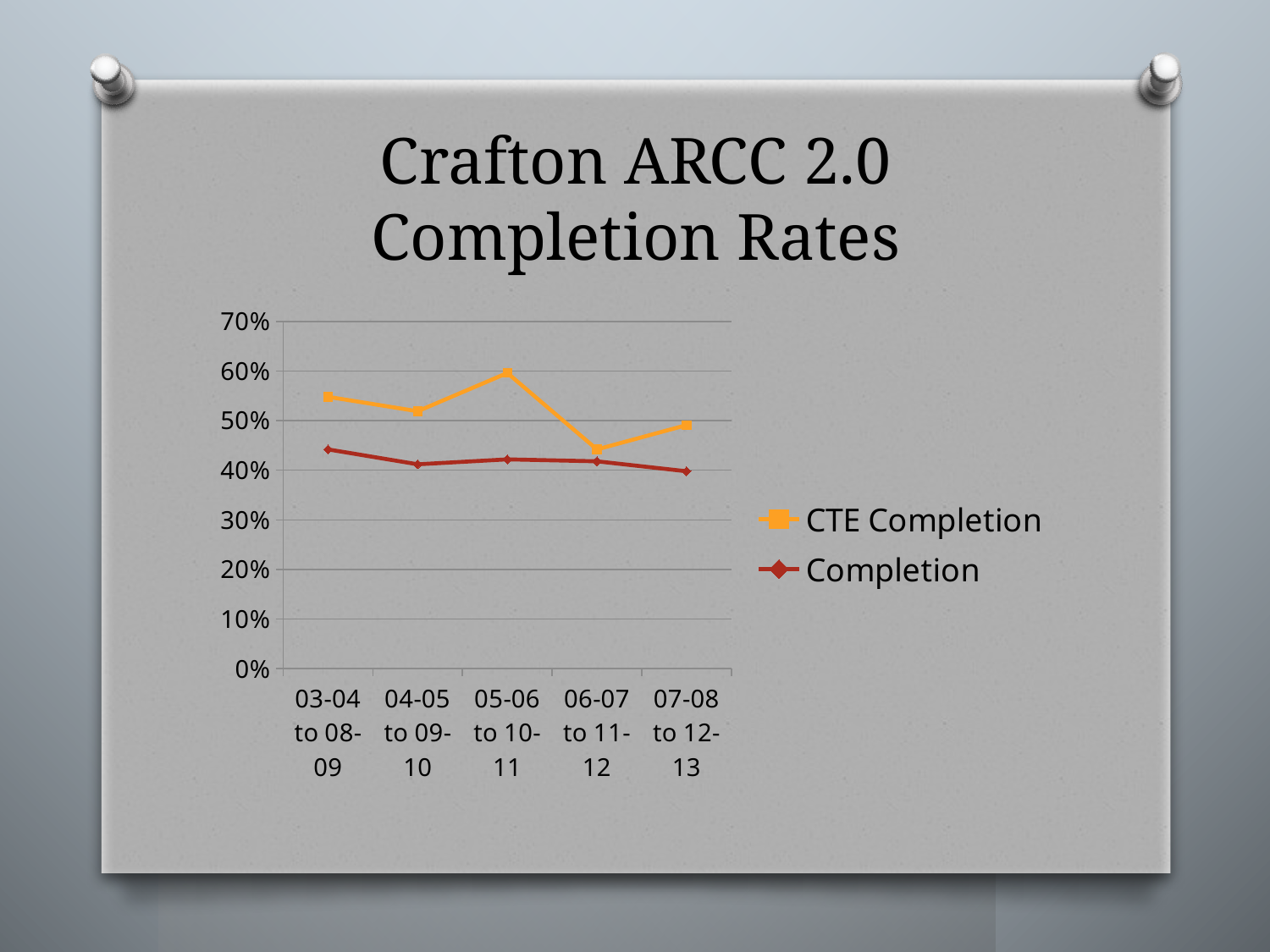
Is the CTE Completion value for 05-06 to 10-11 greater or less than 50%? greater For which cohort period is CTE Completion lowest? 06-07 to 11-12 How many cohort periods are shown on the x axis? 5 For 05-06 to 10-11, which series has the higher value, CTE Completion or Completion? CTE Completion What kind of chart is shown on the slide? Line chart How many series does the legend list? 2 For which cohort period is CTE Completion highest? 05-06 to 10-11 Does the Completion series generally rise or fall from 03-04 to 08-09 through 07-08 to 12-13? Fall Which series is drawn in orange with square markers? CTE Completion Is the Completion value for 03-04 to 08-09 greater or less than 40%? greater Is the CTE Completion value for 06-07 to 11-12 greater or less than 50%? less What is the title of the chart on the slide? Crafton ARCC 2.0 Completion Rates